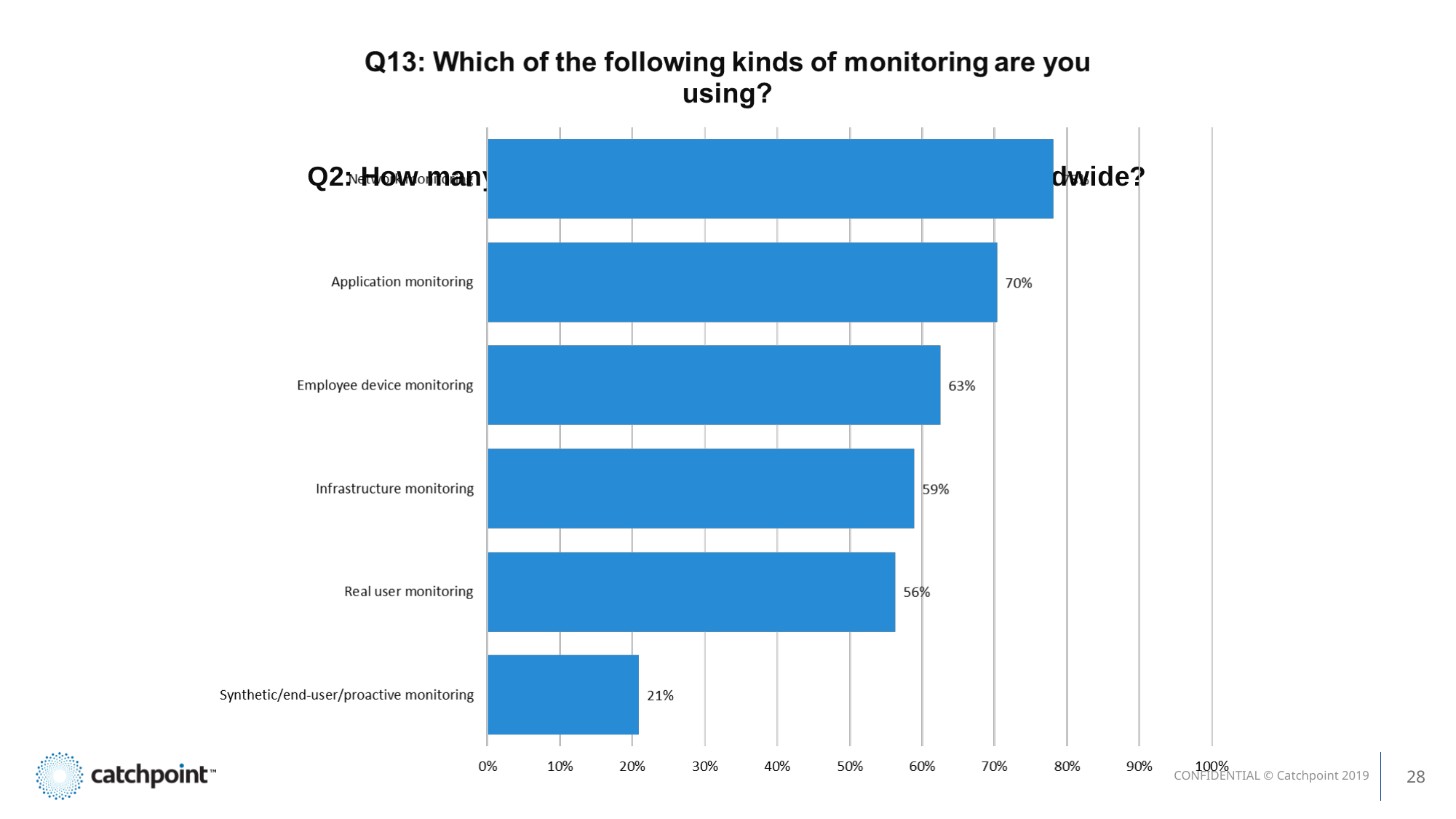
How many kinds of monitoring are shown in the chart? 6 Which kind of monitoring has the lowest value? Synthetic/end-user/proactive monitoring What is the value for Real user monitoring? 56% Which is larger, Infrastructure monitoring or Real user monitoring? Infrastructure monitoring Is the value for Synthetic/end-user/proactive monitoring greater or less than 30%? less What is the value for Synthetic/end-user/proactive monitoring? 21% What kind of chart is shown on the slide? bar chart What is the difference between Application monitoring and Employee device monitoring? 7 percentage points What is the value for Infrastructure monitoring? 59% What is the title of the chart? Q13: Which of the following kinds of monitoring are you using? What is the value for Employee device monitoring? 63% What is the value for Application monitoring? 70%